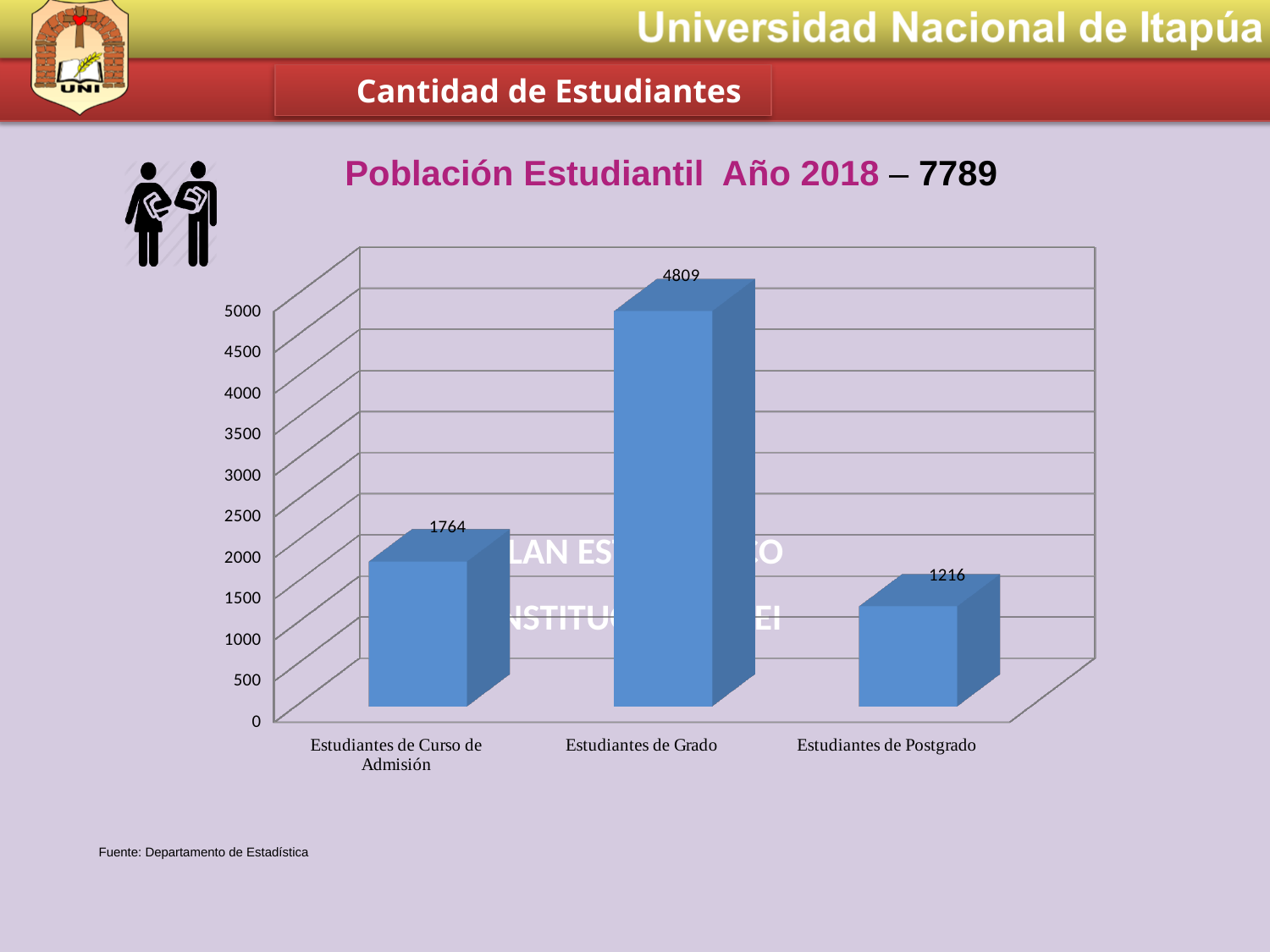
Is the value for Estudiantes de Grado greater or less than 4500? greater How many categories are shown in the chart? 3 What is the value for Estudiantes de Postgrado? 1216 Which is larger, the value for Estudiantes de Curso de Admisión or Estudiantes de Postgrado? Estudiantes de Curso de Admisión What is the value for Estudiantes de Curso de Admisión? 1764 What total student population for 2018 is stated in the heading above the chart? 7789 What is the value for Estudiantes de Grado? 4809 Which category has the highest value? Estudiantes de Grado What is the difference between the values for Estudiantes de Curso de Admisión and Estudiantes de Postgrado? 548 What is the difference between the values for Estudiantes de Grado and Estudiantes de Curso de Admisión? 3045 What kind of chart is shown on the slide? bar chart Which category has the lowest value? Estudiantes de Postgrado